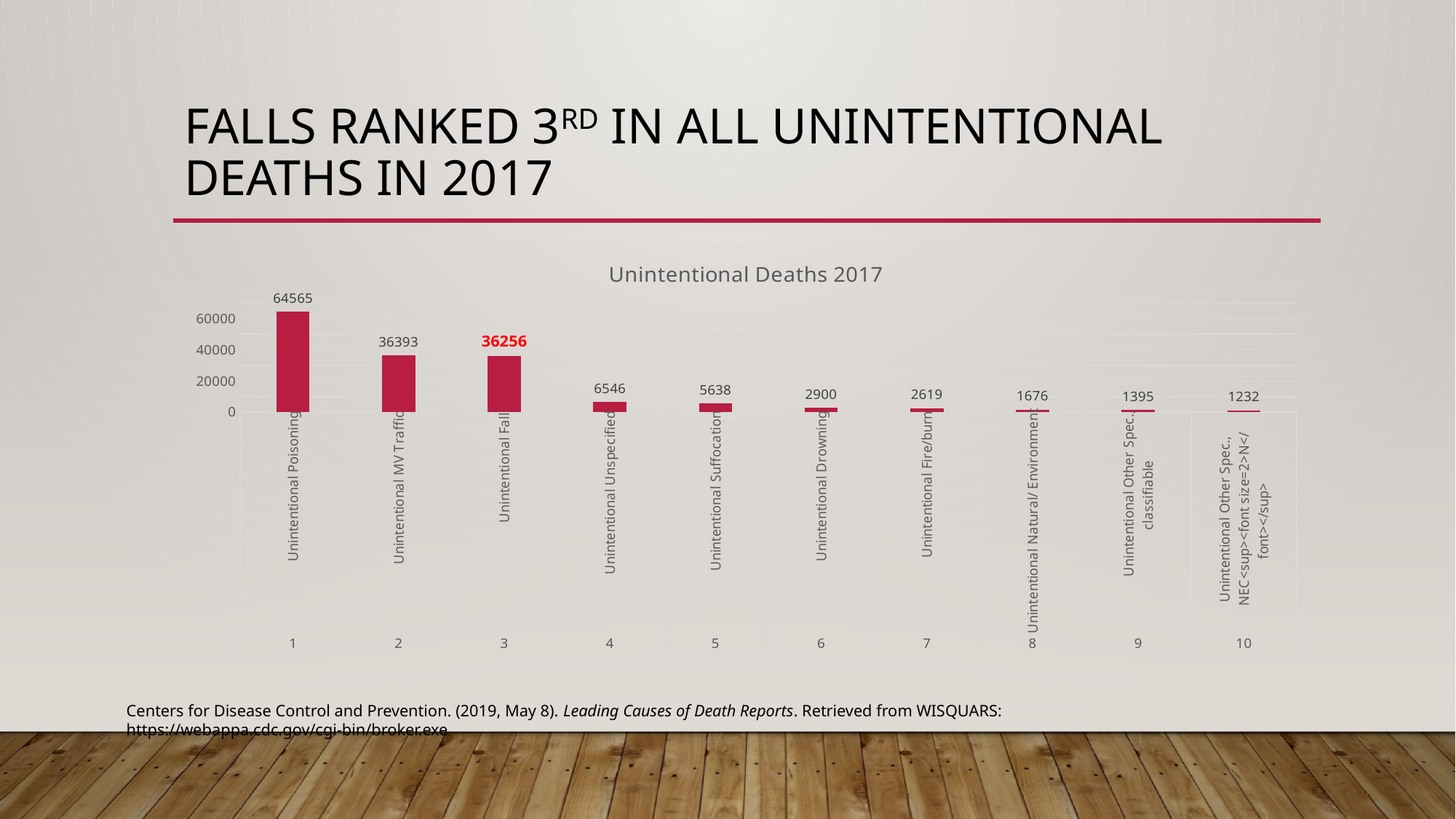
How many categories are shown in the chart? 10 What is the title of the chart? Unintentional Deaths 2017 Which category has the lowest value? Unintentional Other Spec., NEC What is the value for Unintentional Fall? 36256 What is the value for Unintentional Drowning? 2900 What kind of chart is this? Bar chart What is the difference between Unintentional MV Traffic and Unintentional Fall? 137 Which is larger, Unintentional Unspecified or Unintentional Suffocation? Unintentional Unspecified What is the difference between Unintentional Poisoning and Unintentional MV Traffic? 28172 What is the value for Unintentional Suffocation? 5638 Which category has the highest value? Unintentional Poisoning What is the value for Unintentional Poisoning? 64565